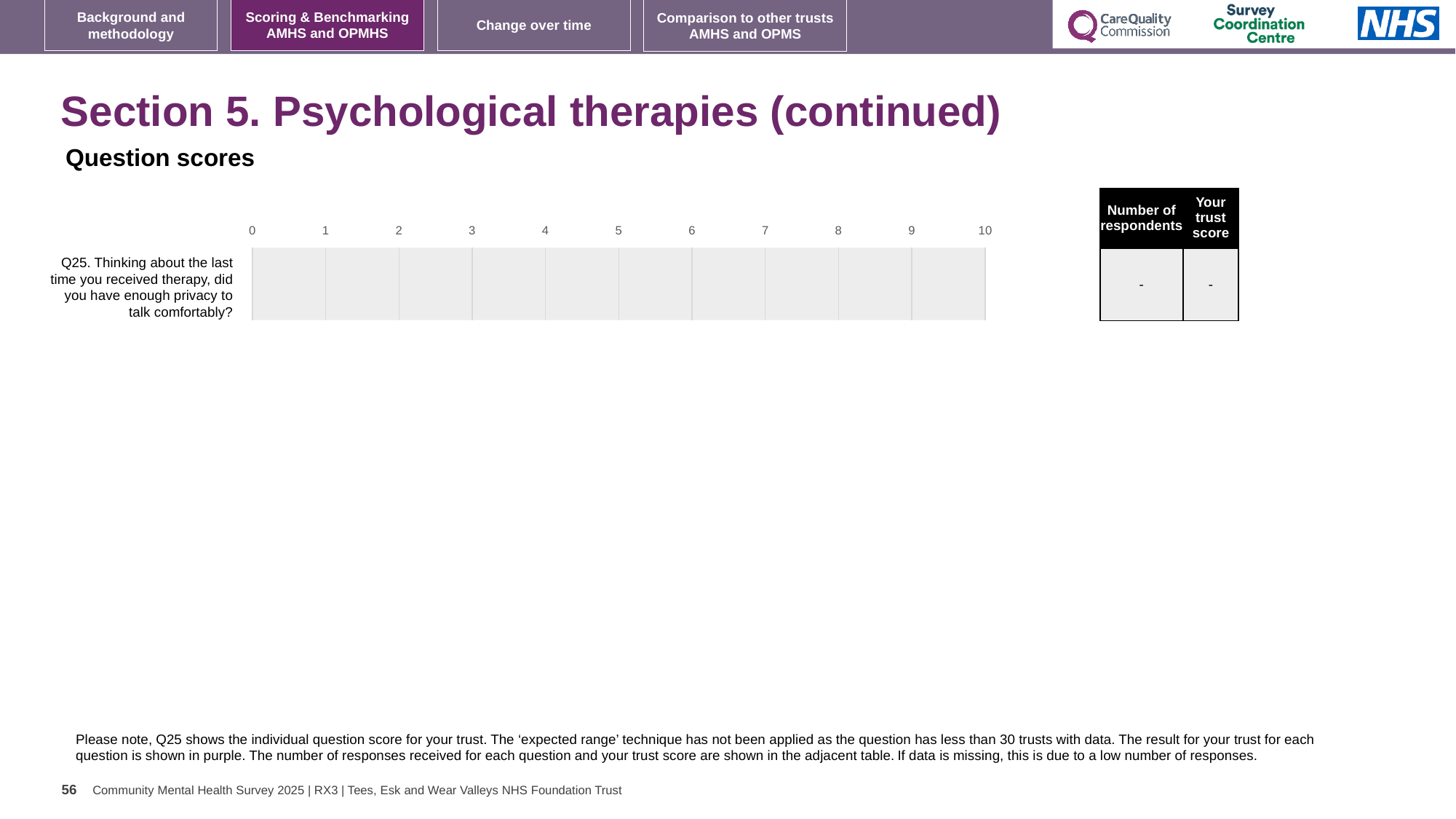
What kind of chart is shown on the slide? bar chart What value is shown in the 'Your trust score' column for Q25? - Is a bar plotted for Q25 on the chart? No What is the minimum value shown on the chart's x axis? 0 What is the maximum value shown on the chart's x axis? 10 What value is shown in the 'Number of respondents' column for Q25? - How many questions (categories) are listed on the chart? 1